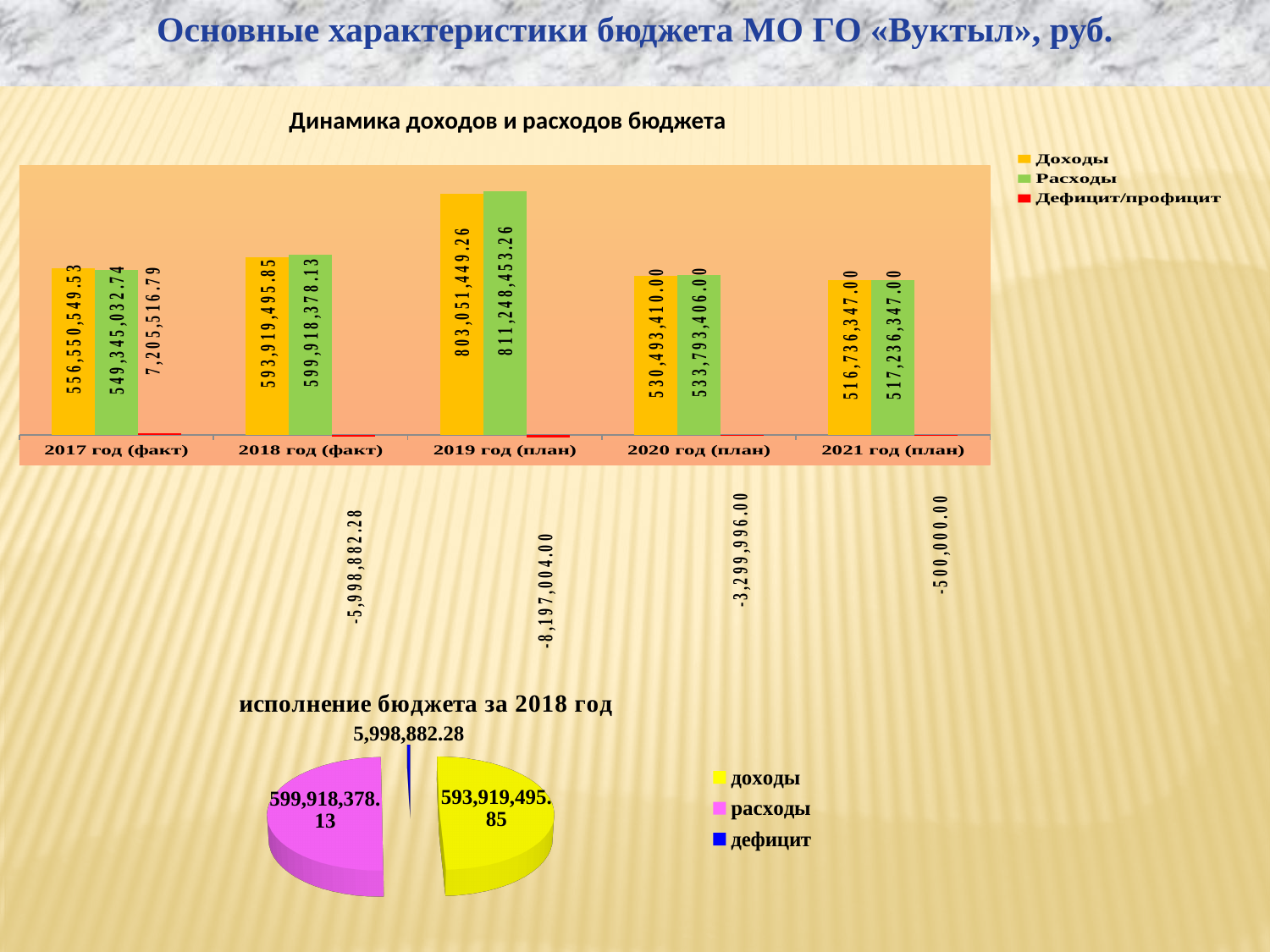
How many year categories are shown on the x axis of the chart 'Динамика доходов и расходов бюджета'? 5 In the chart 'Динамика доходов и расходов бюджета', which year has the lowest Расходы? 2021 год (план) How many series does the legend of the chart 'Динамика доходов и расходов бюджета' list? 3 In the chart 'Динамика доходов и расходов бюджета', what is the value of Расходы for 2020 год (план)? 533,793,406.00 In the pie chart 'исполнение бюджета за 2018 год', what is the value of the расходы slice? 599,918,378.13 In the chart 'Динамика доходов и расходов бюджета', what is the Дефицит/профицит value for 2021 год (план)? -500,000.00 What kind of chart is 'Динамика доходов и расходов бюджета'? Bar chart In the chart 'Динамика доходов и расходов бюджета', do Доходы rise or fall from 2019 год (план) to 2021 год (план)? Fall In the chart 'Динамика доходов и расходов бюджета', what is the value of Доходы for 2019 год (план)? 803,051,449.26 In the chart 'Динамика доходов и расходов бюджета', by how much do Расходы exceed Доходы in 2019 год (план)? 8,197,004.00 In the chart 'Динамика доходов и расходов бюджета', which year has the highest Доходы? 2019 год (план) In the chart 'Динамика доходов и расходов бюджета', are Доходы higher in 2018 год (факт) or in 2019 год (план)? 2019 год (план)